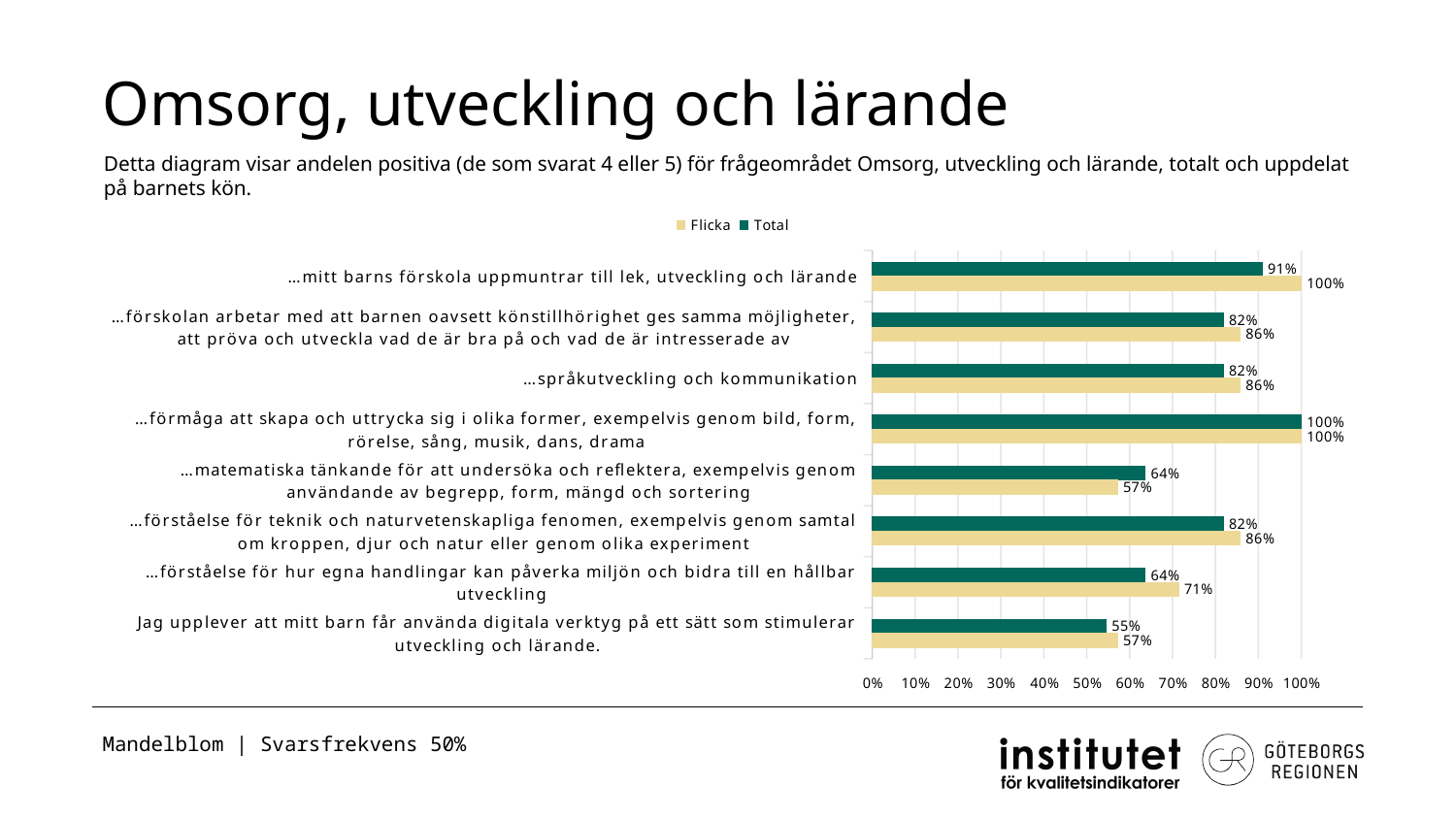
What is the difference between the Flicka and Total values for "…matematiska tänkande för att undersöka och reflektera, exempelvis genom användande av begrepp, form, mängd och sortering"? 7% How many series does the legend list? 2 What kind of chart is shown on the slide? bar chart How many categories are plotted in the chart? 8 What is the Flicka value for "…mitt barns förskola uppmuntrar till lek, utveckling och lärande"? 100% What is the Total value for "Jag upplever att mitt barn får använda digitala verktyg på ett sätt som stimulerar utveckling och lärande."? 55% What is the Total value for "…språkutveckling och kommunikation"? 82% What are the two series named in the legend? Flicka and Total Which category has the lowest Total value? Jag upplever att mitt barn får använda digitala verktyg på ett sätt som stimulerar utveckling och lärande. Which category has the highest Total value? …förmåga att skapa och uttrycka sig i olika former, exempelvis genom bild, form, rörelse, sång, musik, dans, drama For "…förståelse för teknik och naturvetenskapliga fenomen, exempelvis genom samtal om kroppen, djur och natur eller genom olika experiment", which is larger, the Flicka value or the Total value? Flicka What is the Flicka value for "…förståelse för hur egna handlingar kan påverka miljön och bidra till en hållbar utveckling"? 71%